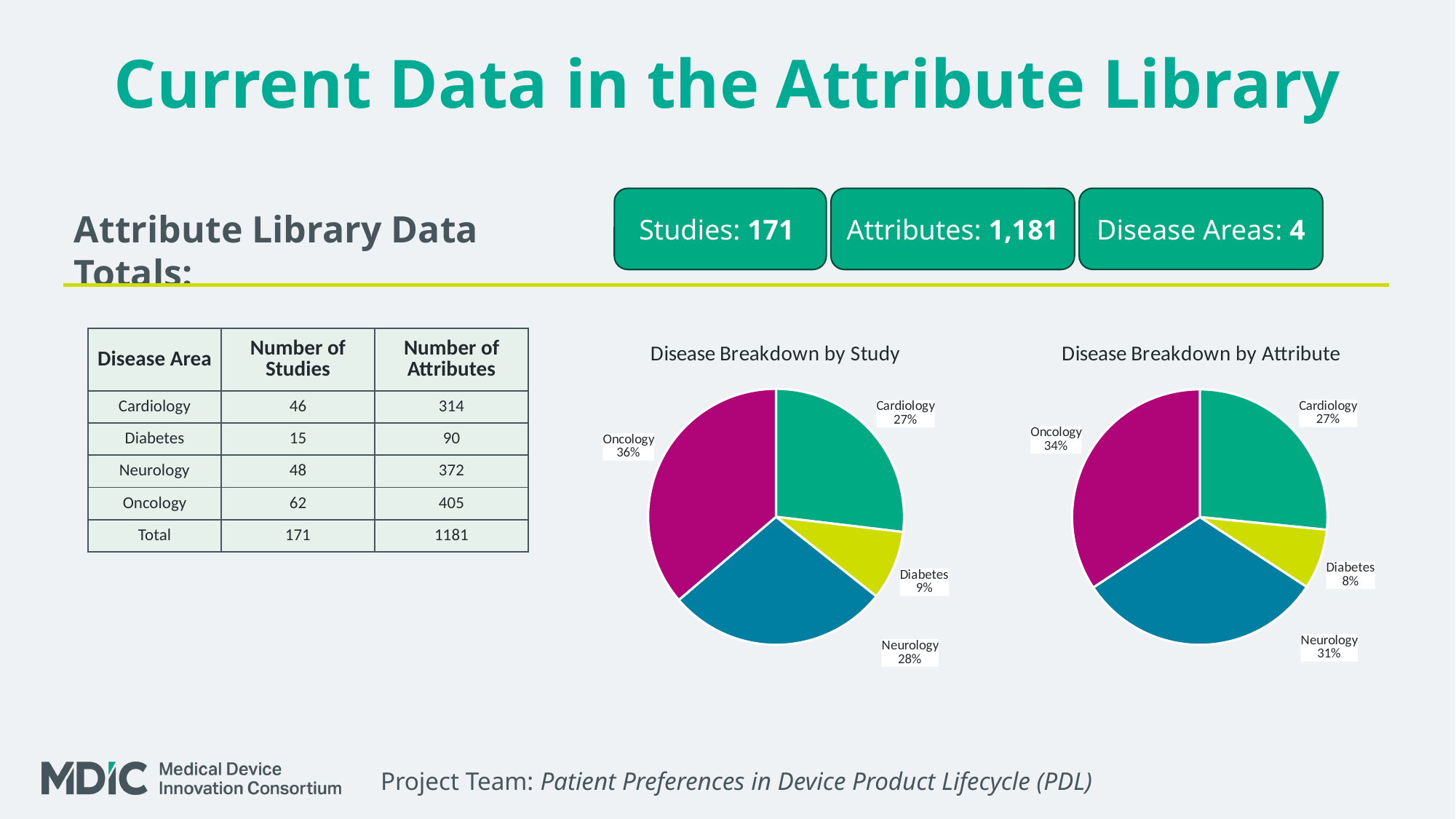
In the 'Disease Breakdown by Study' chart, what percentage is shown for Diabetes? 9% In the 'Disease Breakdown by Attribute' chart, which is larger, Neurology or Cardiology? Neurology In the 'Disease Breakdown by Attribute' chart, what is the difference in percentage points between Oncology and Neurology? 3 In the 'Disease Breakdown by Study' chart, which disease area has the largest slice? Oncology What type of chart is 'Disease Breakdown by Attribute'? Pie chart In the 'Disease Breakdown by Attribute' chart, what share of the pie is Cardiology? 27% In the 'Disease Breakdown by Attribute' chart, what percentage is shown for Neurology? 31% What is the title of the pie chart on the right side of the slide? Disease Breakdown by Attribute In the 'Disease Breakdown by Attribute' chart, which disease area has the smallest slice? Diabetes How many slices does the 'Disease Breakdown by Study' pie chart have? 4 In the 'Disease Breakdown by Study' chart, what share of the pie is Oncology? 36% In the 'Disease Breakdown by Study' chart, what is the difference in percentage points between Oncology and Diabetes? 27